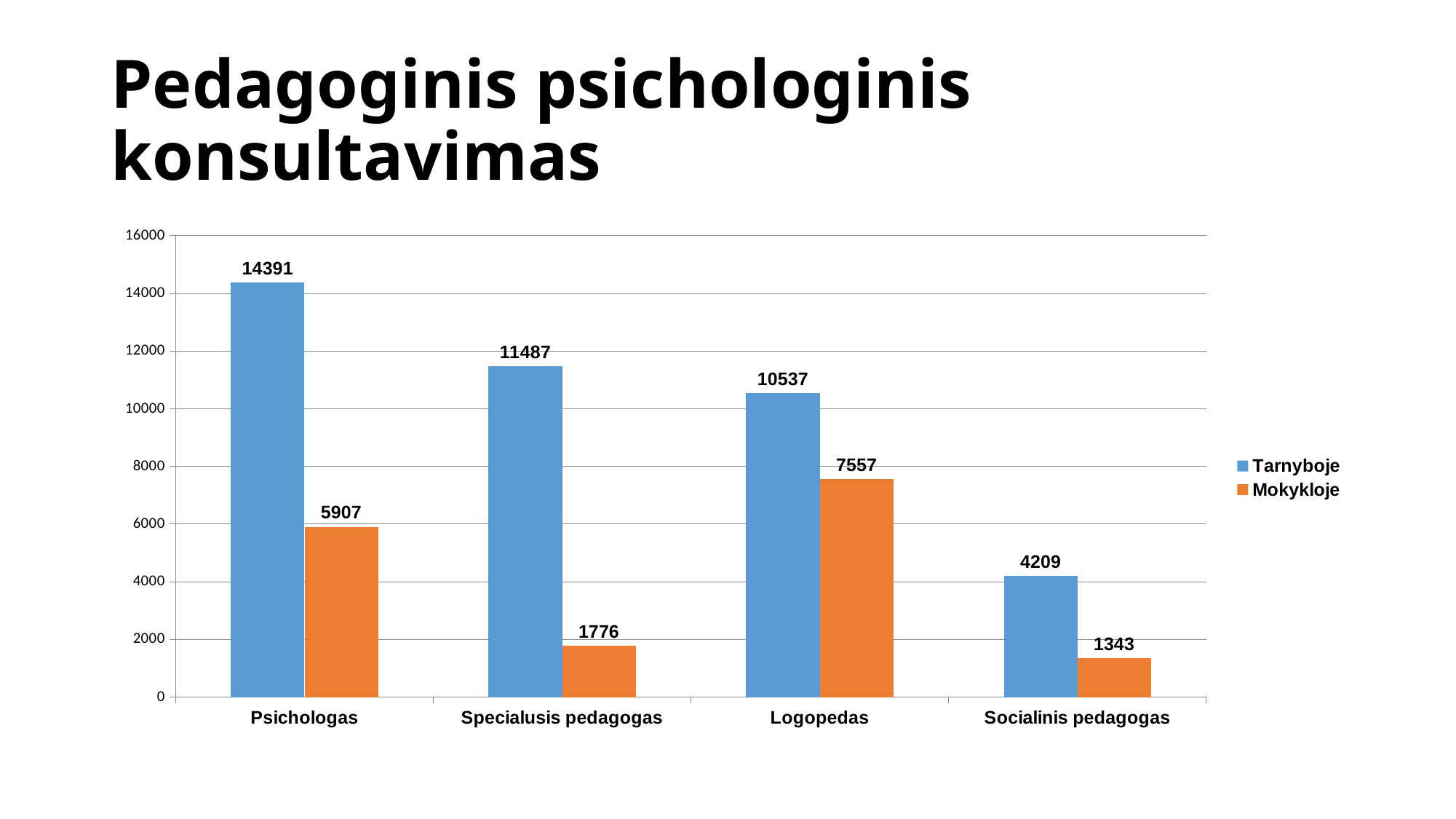
How many series does the legend list? 2 Which is larger: the Mokykloje value for Psichologas or the Mokykloje value for Logopedas? Logopedas How many categories are shown on the x axis? 4 Which category has the lowest Mokykloje value? Socialinis pedagogas What is the difference between the Tarnyboje and Mokykloje values for Psichologas? 8484 Which category has the highest Tarnyboje value? Psichologas Which colour represents the Mokykloje series? Orange What is the difference between the Tarnyboje values for Specialusis pedagogas and Logopedas? 950 What is the Mokykloje value for Specialusis pedagogas? 1776 What kind of chart is shown on the slide? Bar chart What is the Mokykloje value for Logopedas? 7557 What is the Tarnyboje value for Psichologas? 14391